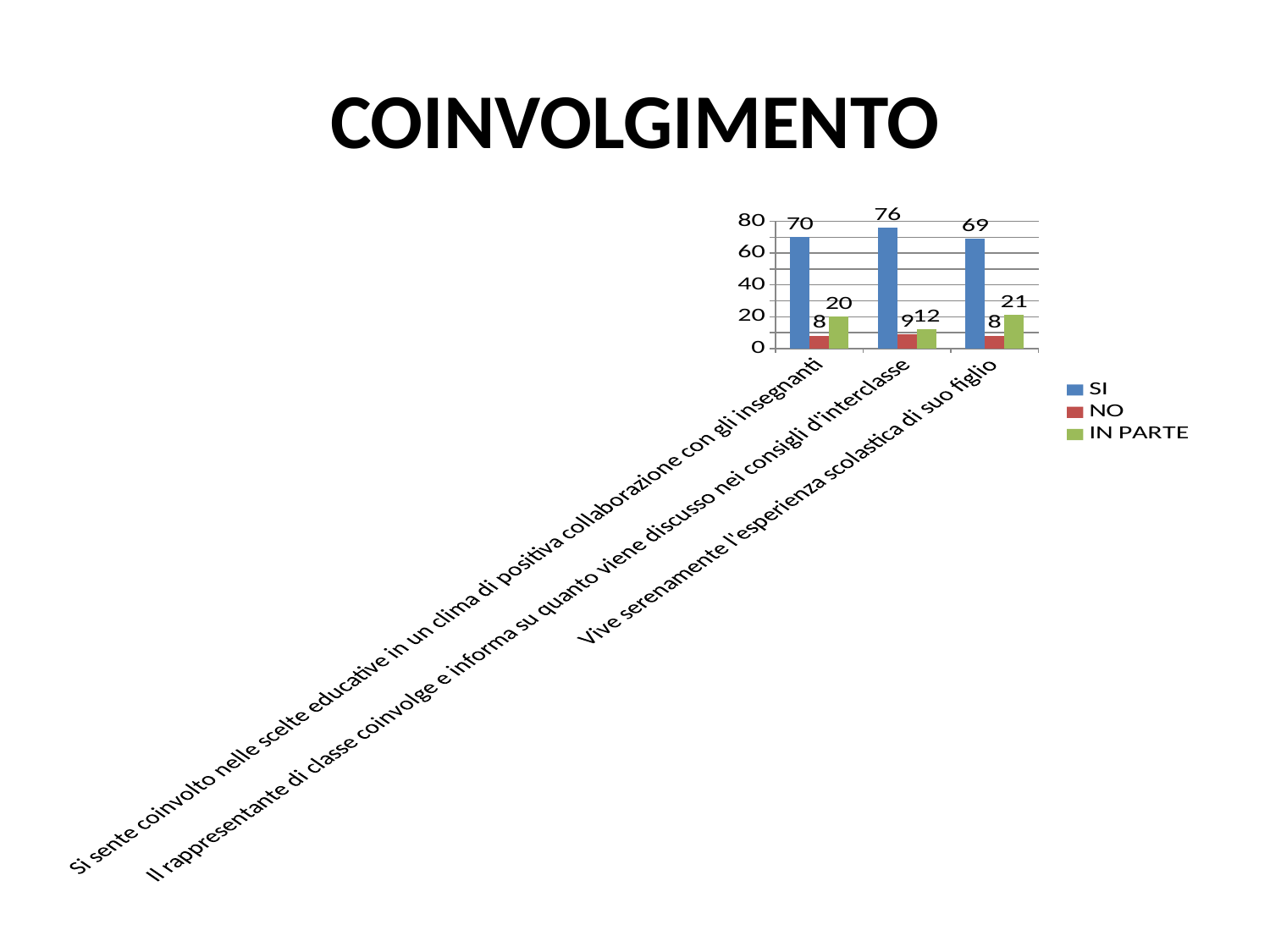
What is the SI value for "Il rappresentante di classe coinvolge e informa su quanto viene discusso nei consigli d'interclasse"? 76 What is the IN PARTE value for "Vive serenamente l'esperienza scolastica di suo figlio"? 21 What is the title of the slide containing the chart? COINVOLGIMENTO What is the difference between the SI value and the IN PARTE value for "Vive serenamente l'esperienza scolastica di suo figlio"? 48 How many categories are shown on the x axis? 3 What is the NO value for "Si sente coinvolto nelle scelte educative in un clima di positiva collaborazione con gli insegnanti"? 8 What kind of chart is shown on the slide? bar chart Which category has the lowest IN PARTE value? Il rappresentante di classe coinvolge e informa su quanto viene discusso nei consigli d'interclasse Which is larger: the IN PARTE value for "Si sente coinvolto nelle scelte educative in un clima di positiva collaborazione con gli insegnanti" or the IN PARTE value for "Il rappresentante di classe coinvolge e informa su quanto viene discusso nei consigli d'interclasse"? Si sente coinvolto nelle scelte educative in un clima di positiva collaborazione con gli insegnanti Which category has the highest SI value? Il rappresentante di classe coinvolge e informa su quanto viene discusso nei consigli d'interclasse Is the SI value for "Vive serenamente l'esperienza scolastica di suo figlio" greater or less than 60? greater How many series does the legend list? 3